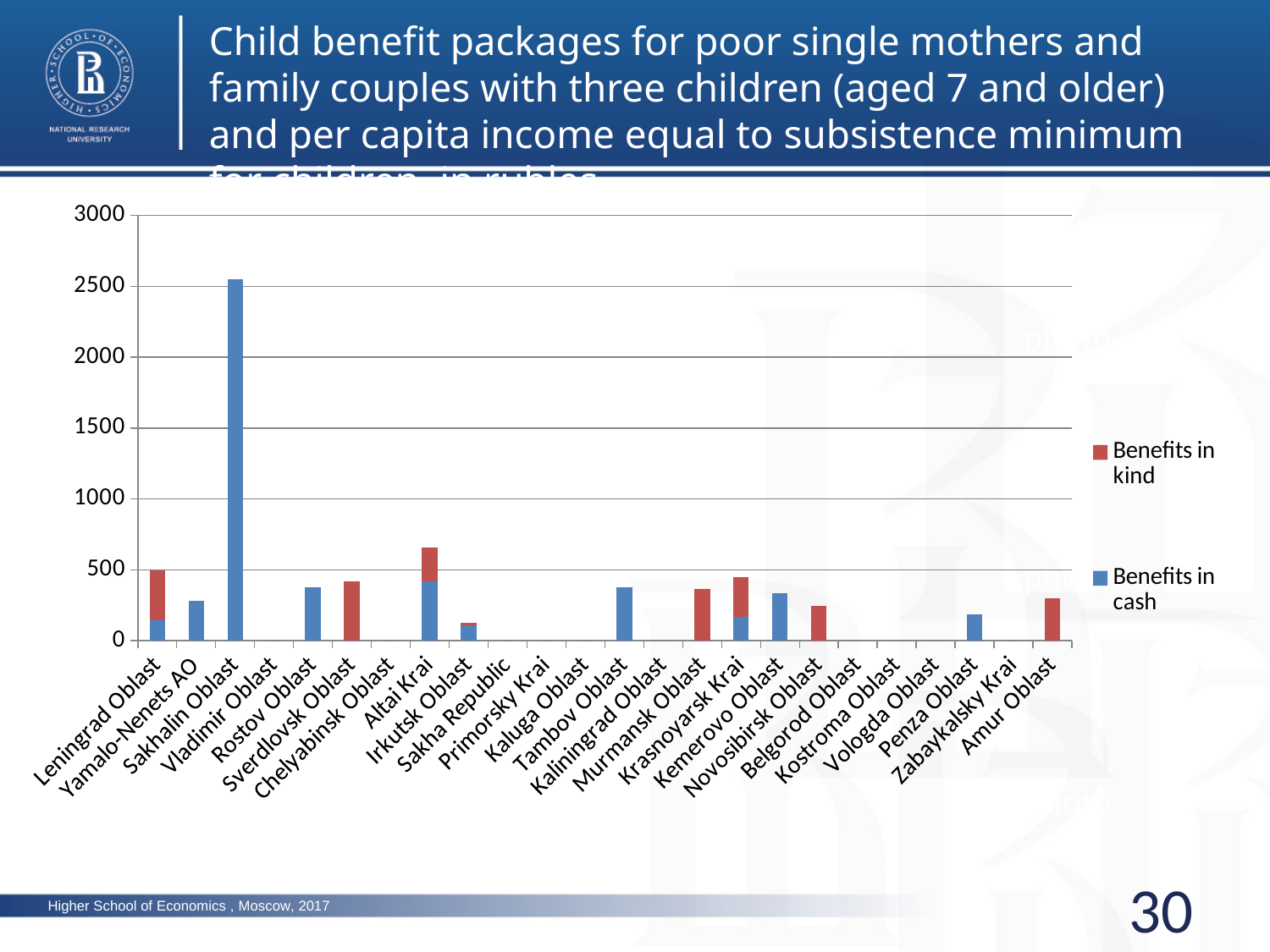
Which region has the highest total bar in the chart? Sakhalin Oblast Which series is shown in blue in the legend? Benefits in cash How many series does the legend list? 2 Is the total value for Altai Krai greater or less than 500? greater Is the value for Penza Oblast greater or less than 500? less Is the value for Irkutsk Oblast greater or less than 500? less Which has a larger total bar, Sakhalin Oblast or Altai Krai? Sakhalin Oblast Which series is shown in red in the legend? Benefits in kind Which has a larger total bar, Altai Krai or Irkutsk Oblast? Altai Krai What kind of chart is shown on the slide? bar chart